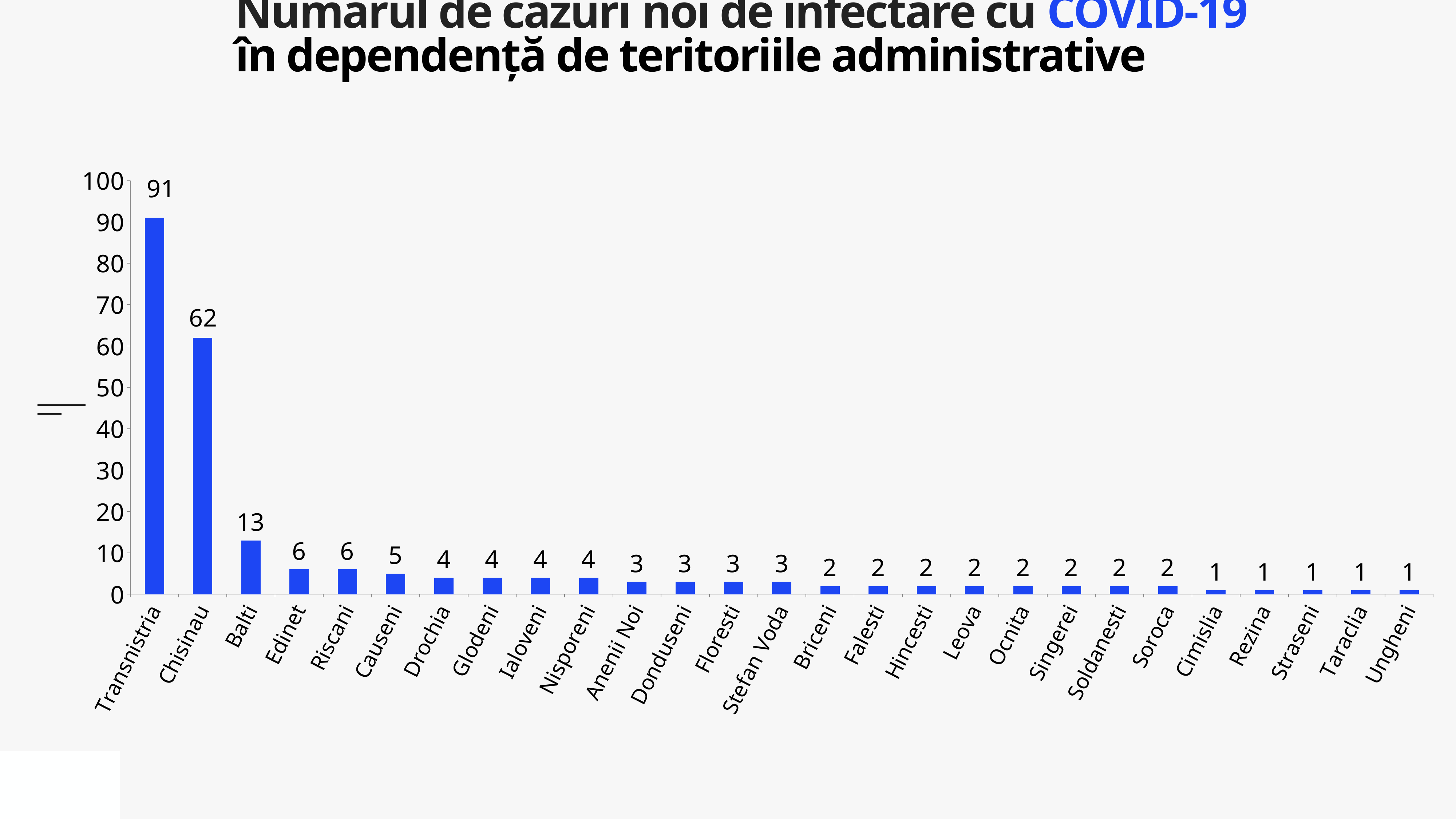
Which is larger, the value for Balti or the value for Edinet? Balti What is the value for Transnistria? 91 What kind of chart is shown on the slide? bar chart Which category has the highest value? Transnistria Do the values rise or fall from left to right along the x axis? fall What is the value for Balti? 13 What is the difference between the values for Chisinau and Balti? 49 How many categories are shown on the x axis? 27 What is the value for Chisinau? 62 Is the value for Chisinau greater or less than 50? greater What is the difference between the values for Transnistria and Chisinau? 29 What is the value for Causeni? 5